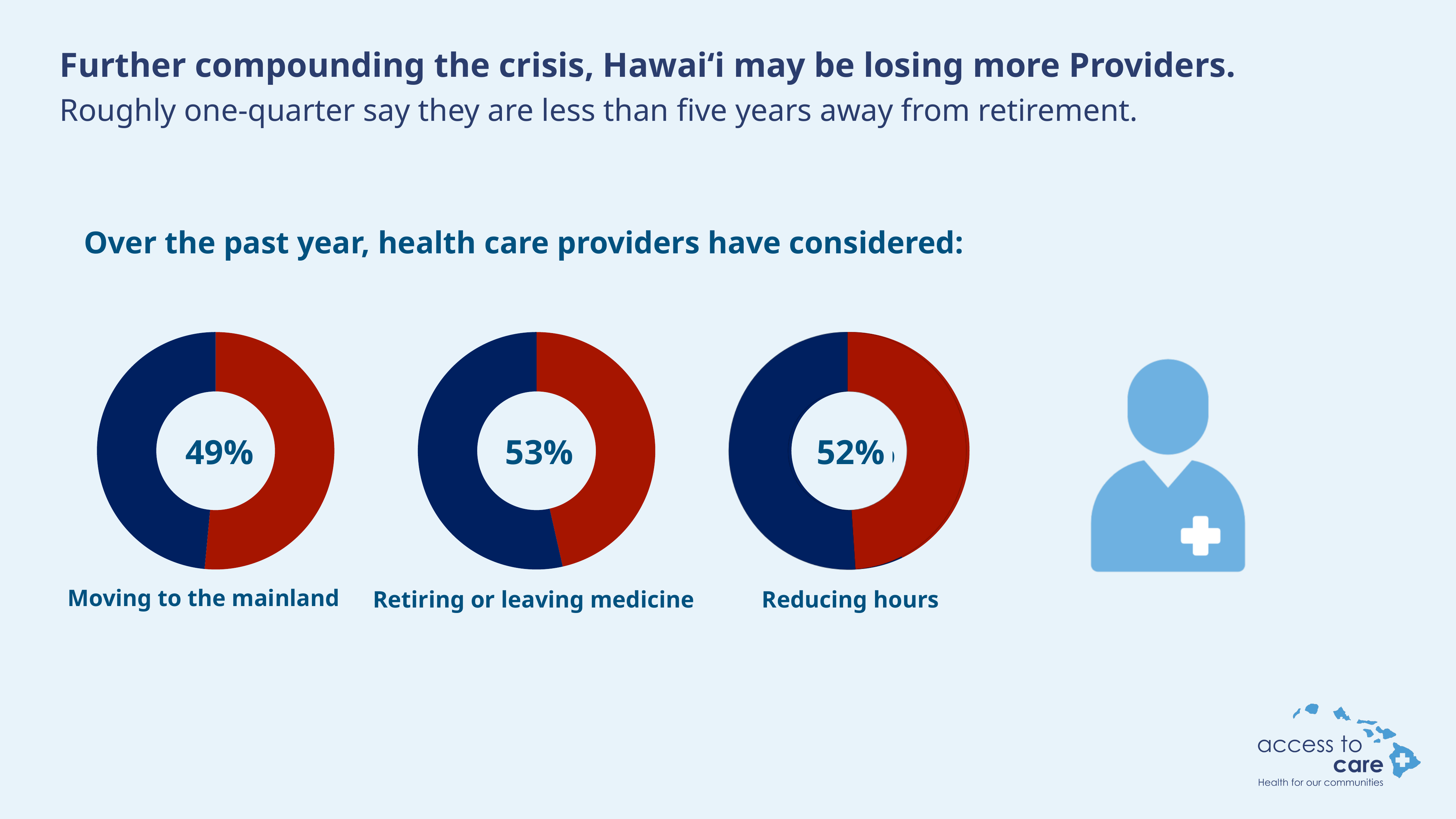
How many donut charts are shown on the slide? 3 What kind of chart is used to show the percentage for 'Moving to the mainland'? Donut chart Across the three donut charts, which option has the lowest percentage of providers who considered it? Moving to the mainland In the 'Retiring or leaving medicine' donut chart, what percentage is shown in the centre? 53% What is the difference between the percentage in the 'Reducing hours' chart and the percentage in the 'Moving to the mainland' chart? 3% What two colours are used for the segments of the donut charts? Dark blue and red In the 'Moving to the mainland' donut chart, what percentage is shown in the centre? 49% Which is larger: the percentage in the 'Reducing hours' chart or the percentage in the 'Moving to the mainland' chart? Reducing hours Across the three donut charts, which option has the highest percentage of providers who considered it? Retiring or leaving medicine Which is larger: the percentage in the 'Retiring or leaving medicine' chart or the percentage in the 'Reducing hours' chart? Retiring or leaving medicine What is the difference between the percentage in the 'Retiring or leaving medicine' chart and the percentage in the 'Moving to the mainland' chart? 4% In the 'Reducing hours' donut chart, what percentage is shown in the centre? 52%